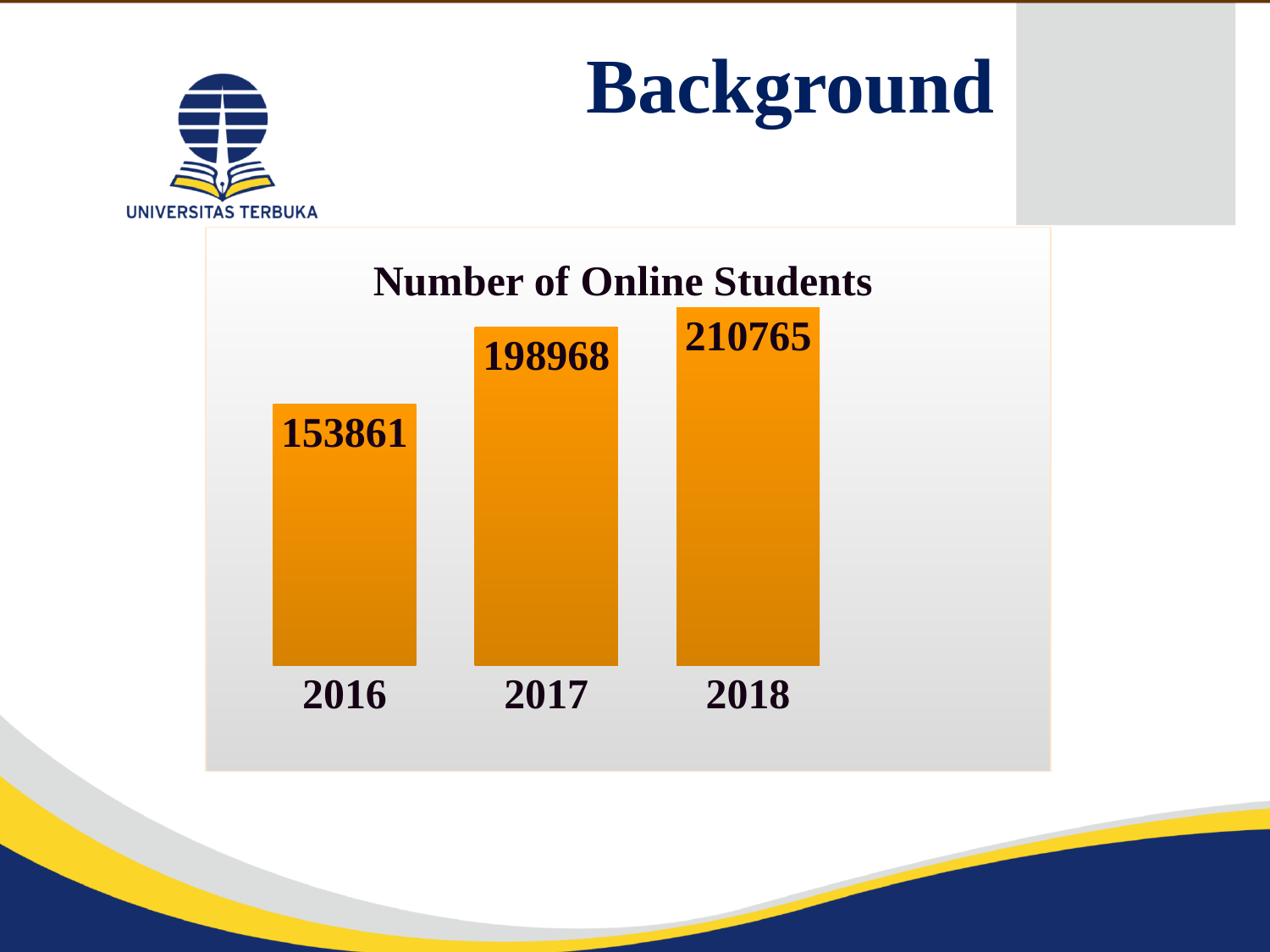
What is the number of online students in 2016? 153861 Which year has the lowest number of online students? 2016 What is the difference in the number of online students between 2018 and 2017? 11797 Which year has the highest number of online students? 2018 How many years are shown in the chart? 3 What is the number of online students in 2018? 210765 What kind of chart is shown on the slide? Bar chart Which year has more online students, 2016 or 2017? 2017 What is the title of the chart? Number of Online Students What is the number of online students in 2017? 198968 Does the number of online students rise or fall from 2016 to 2018? Rise What is the difference in the number of online students between 2017 and 2016? 45107